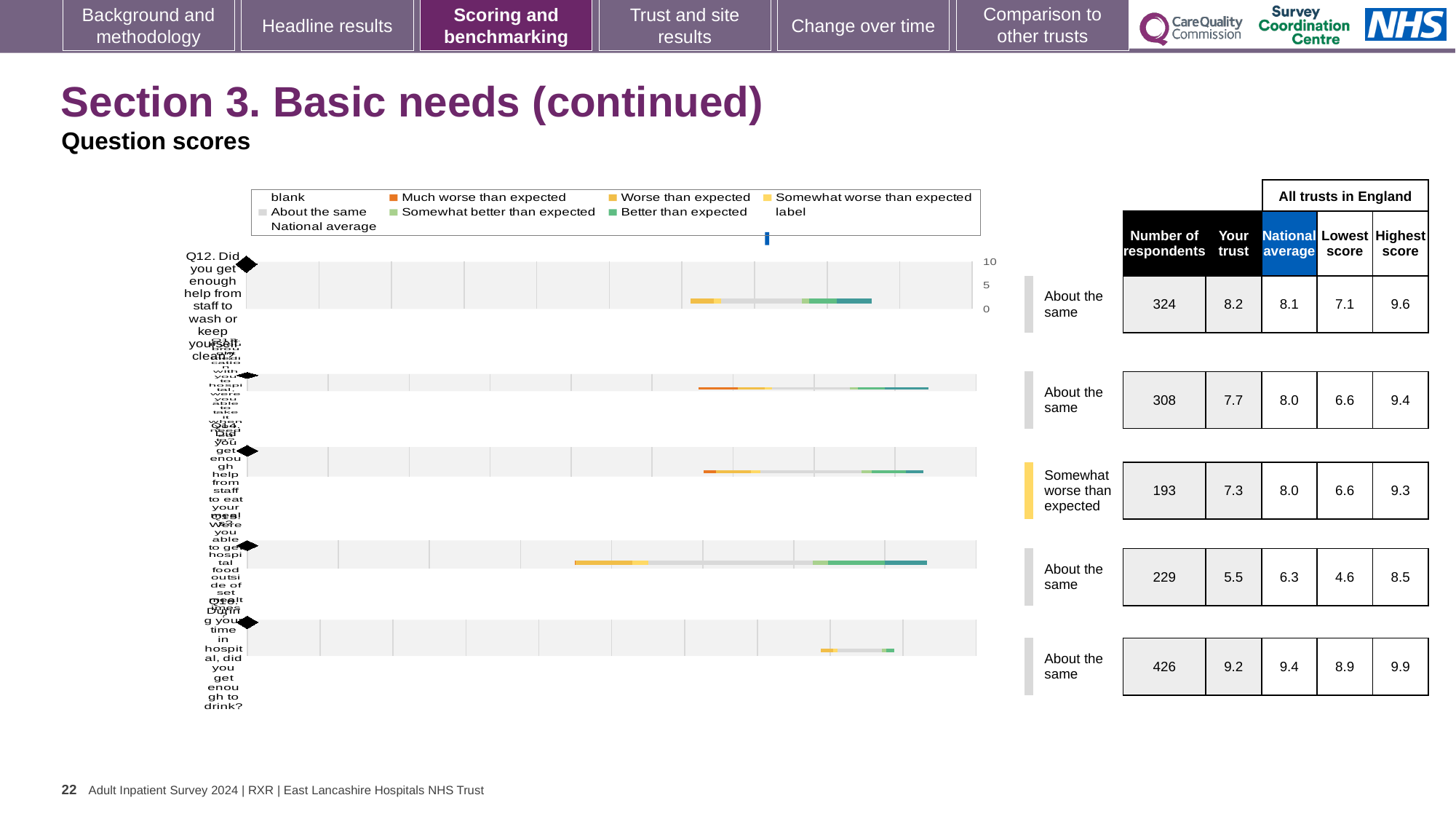
Which legend entry is shown in orange? Much worse than expected Which benchmark label is given to the third question row of the chart? Somewhat worse than expected Which question row has the lowest 'Your trust' score in the table? the fourth row (5.5) Which question row has the highest 'Your trust' score in the table? the fifth row (9.2) How many respondents are listed for the first question row (Q12)? 324 What kind of chart is shown on the slide? bar chart How many question rows (bars) are plotted in the chart? 5 What is the difference between the highest score and the lowest score for Q12 in the table? 2.5 What is the national average for Q12 (help from staff to wash or keep yourself clean) in the table beside the chart? 8.1 What is the 'Your trust' score for Q12 (Did you get enough help from staff to wash or keep yourself clean?) in the table beside the chart? 8.2 Is the 'Your trust' score for Q12 greater or less than the national average for Q12? greater What colour is the legend entry 'Somewhat worse than expected'? yellow